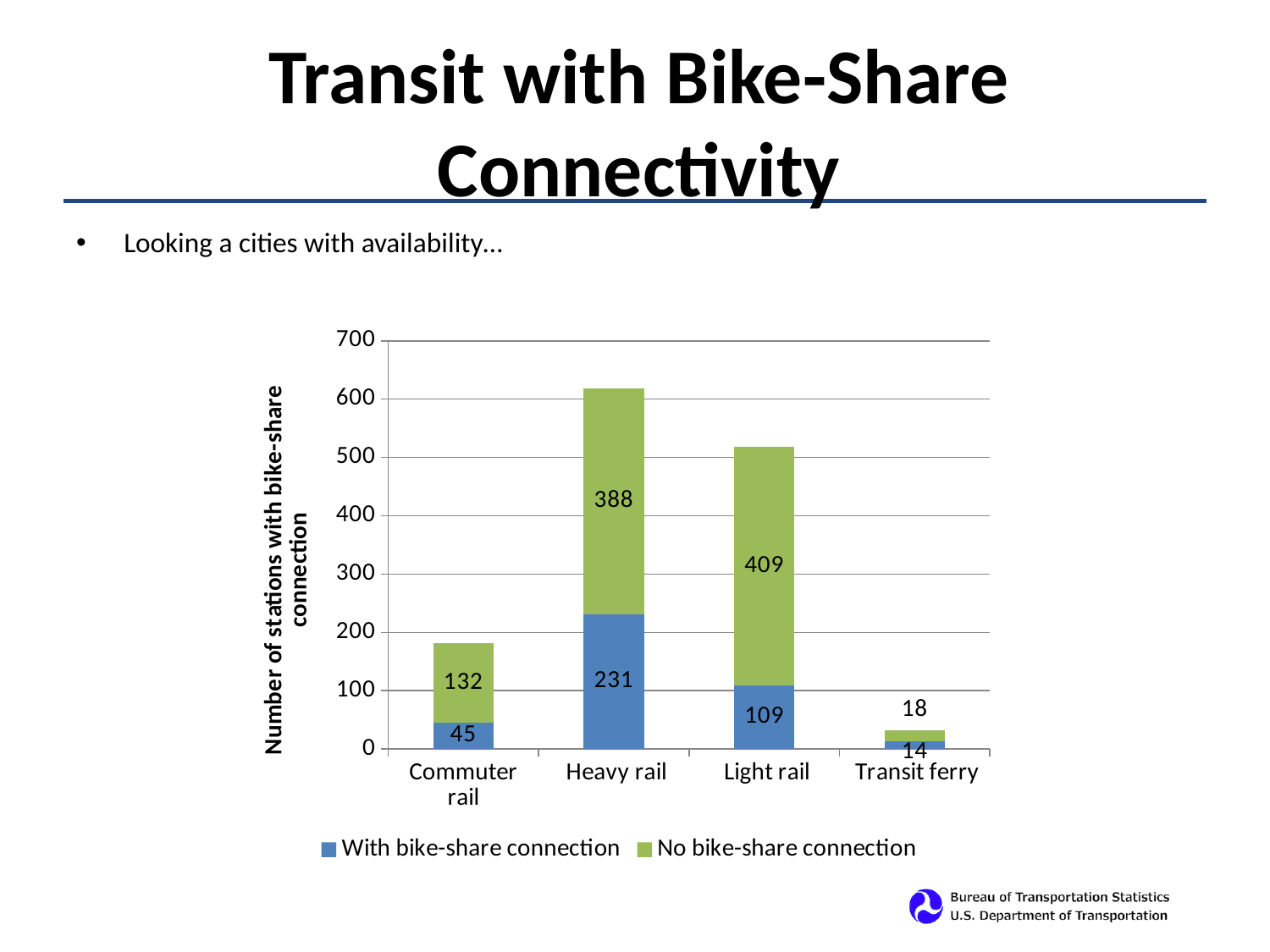
What is the value for No bike-share connection for Light rail? 409 What is the value for With bike-share connection for Transit ferry? 14 What kind of chart is shown on the slide? Stacked bar chart What is the total number of stations for Commuter rail (both series combined)? 177 How many stations with a bike-share connection are there for Heavy rail? 231 Is the total height of the Heavy rail bar greater or less than 600? greater How many series does the legend list? 2 Which category has the lowest number of stations with no bike-share connection? Transit ferry Which category has the highest number of stations with a bike-share connection? Heavy rail Which is larger: the With bike-share connection value for Commuter rail or for Light rail? Light rail What is the difference between the No bike-share connection values for Light rail and Heavy rail? 21 How many transit categories are shown on the x axis? 4